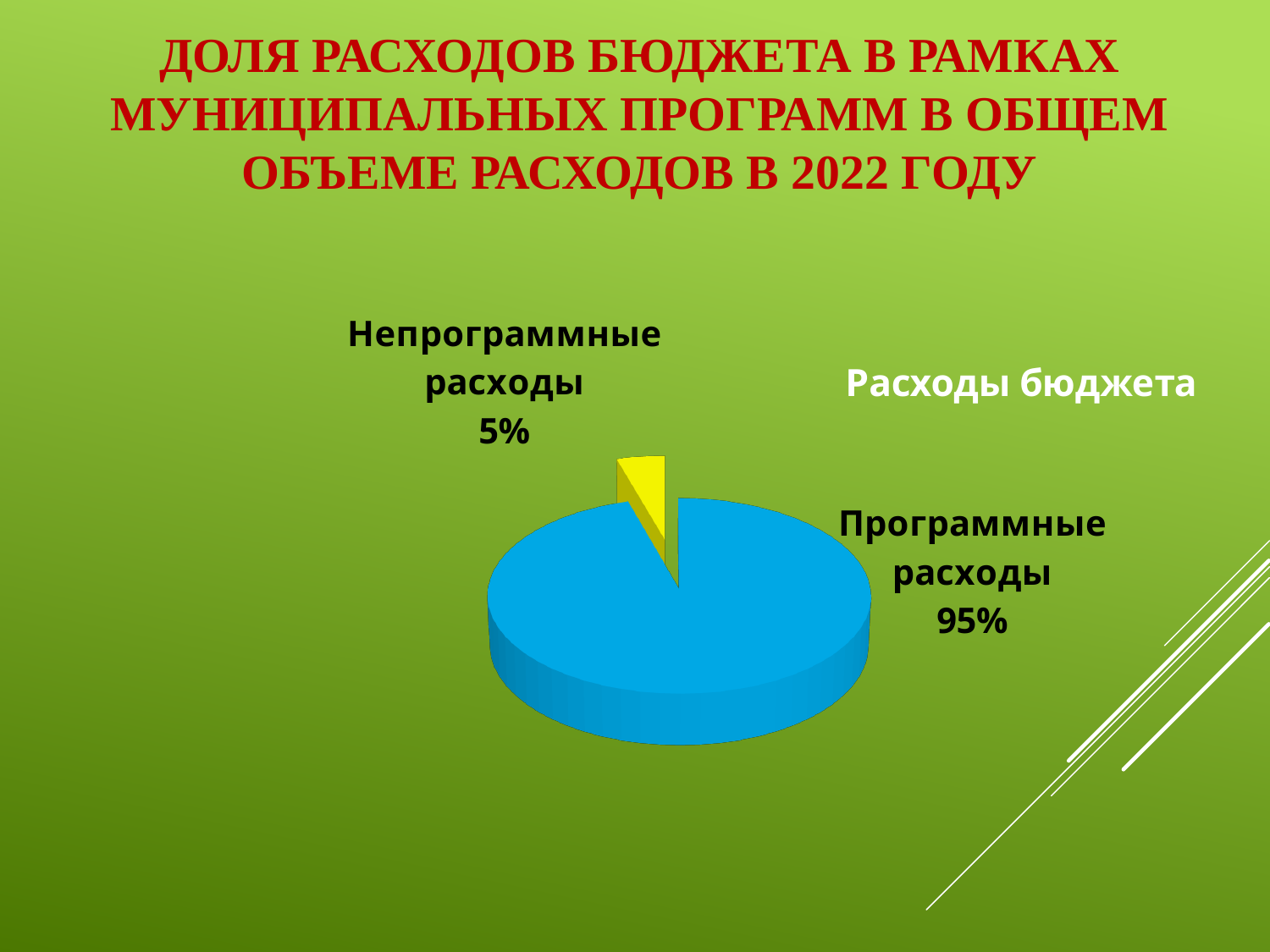
What share of the pie is Программные расходы? 95% What is the difference in percentage points between Программные расходы and Непрограммные расходы? 90 Which slice of the pie is the smallest? Непрограммные расходы What share of the pie is Непрограммные расходы? 5% What colour is the Непрограммные расходы slice? yellow Which is larger, Программные расходы or Непрограммные расходы? Программные расходы What kind of chart is shown on the slide? pie chart How many slices does the pie chart have? 2 Which slice of the pie is the largest? Программные расходы What is the title of the pie chart? Расходы бюджета